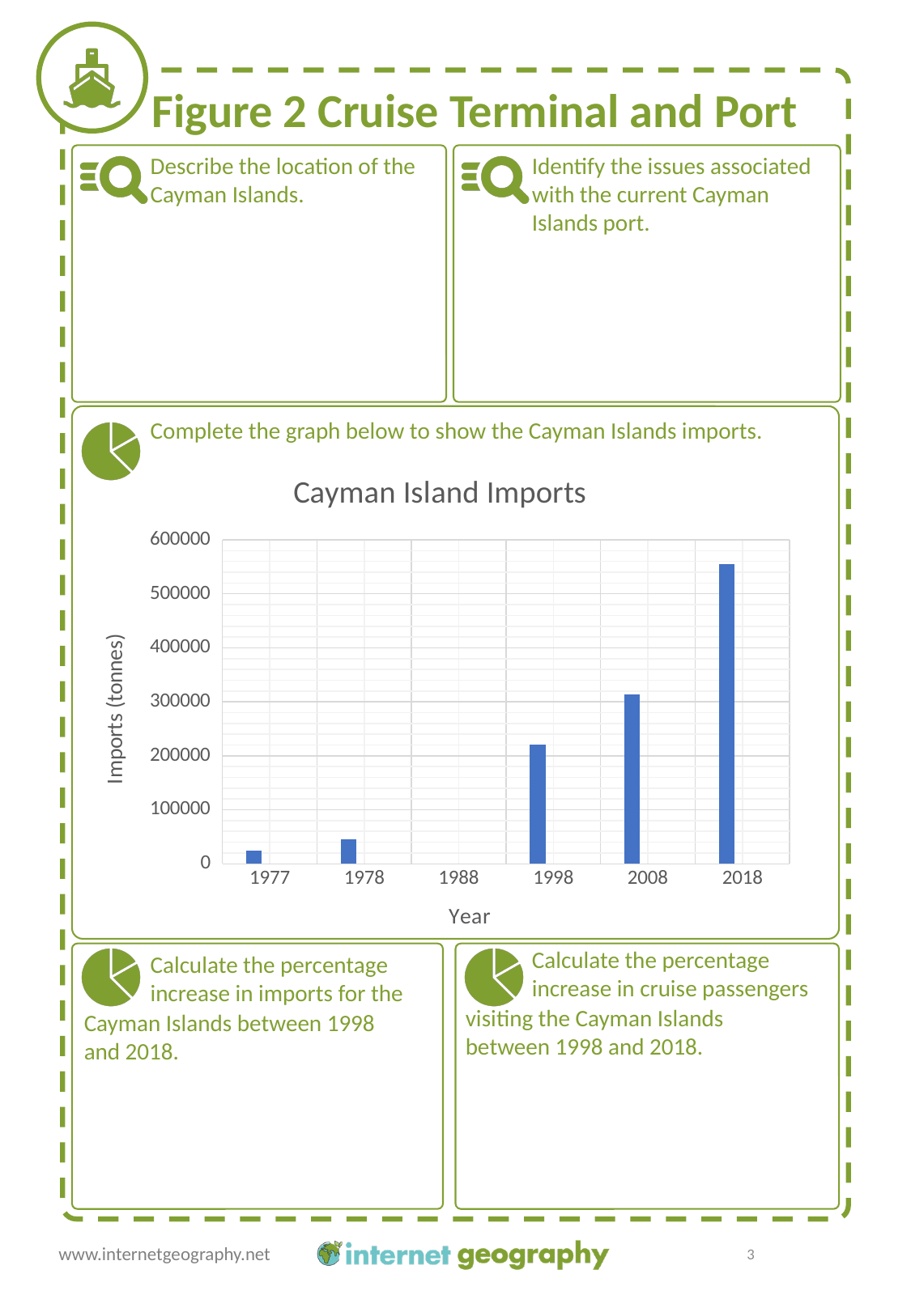
Is the value for 2018 greater or less than 500000? greater Is the value for 2008 greater or less than 200000? greater Which year has higher imports, 2008 or 2018? 2018 What is the title of the chart on the slide? Cayman Island Imports Is the value for 1977 greater or less than 100000? less How many years are shown on the x axis of the Cayman Island Imports chart? 6 What is the label on the y axis of the Cayman Island Imports chart? Imports (tonnes) Which year has the lowest plotted bar in the Cayman Island Imports chart? 1977 Which year has the highest imports in the Cayman Island Imports chart? 2018 What kind of chart is used to show Cayman Island Imports? bar chart Do the plotted imports rise or fall from 1977 to 2018? rise